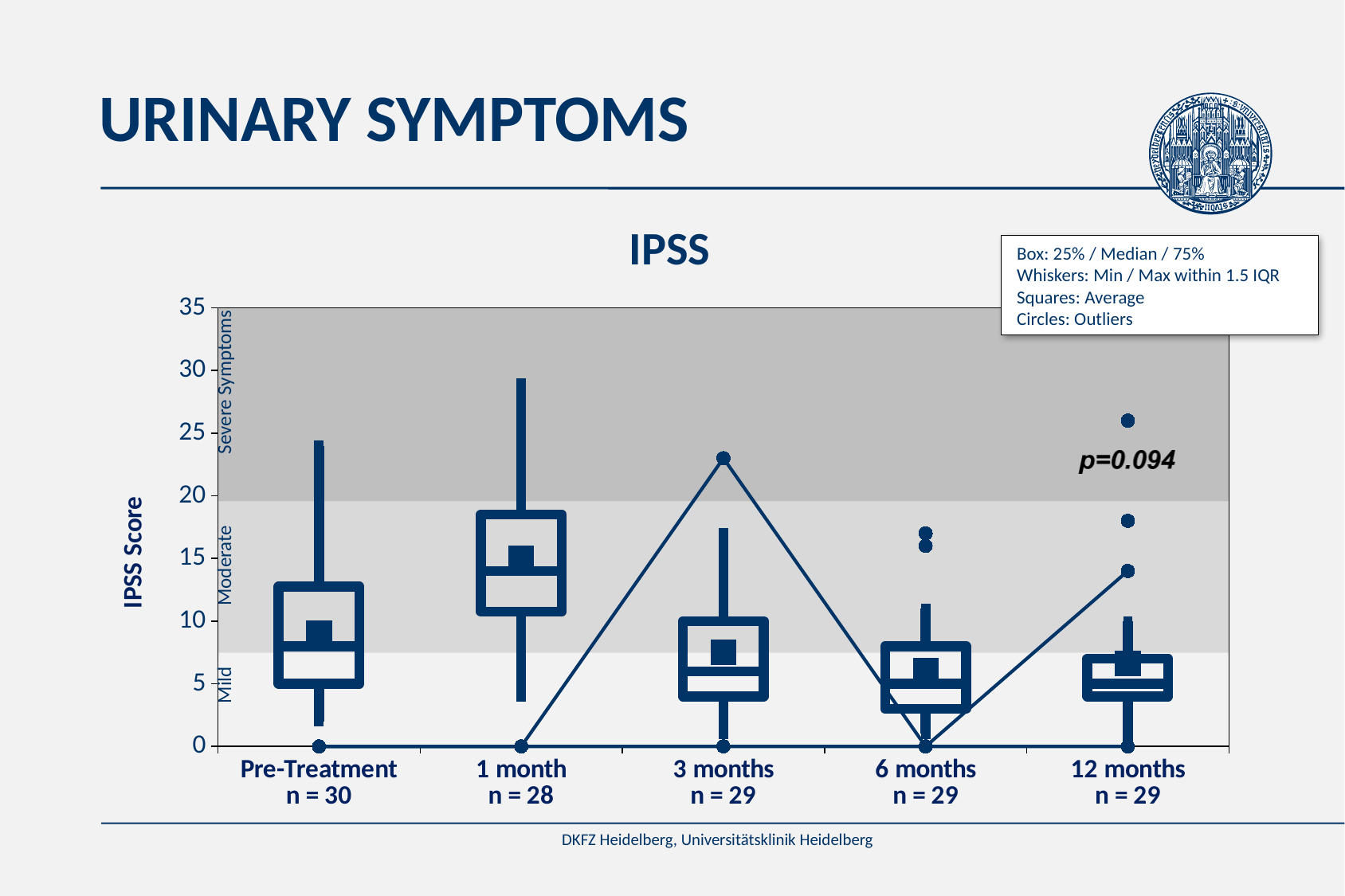
Is the upper whisker at Pre-Treatment greater or less than 20? greater What is the sample size (n) at Pre-Treatment in the IPSS chart? n = 30 What p-value is printed on the IPSS chart? p=0.094 Is the median IPSS score at Pre-Treatment greater or less than 10? less What kind of chart is shown on the slide? Box plot What is the sample size (n) at 1 month in the IPSS chart? n = 28 Which time point has the highest upper whisker in the IPSS chart? 1 month What is the title of the chart? IPSS Is the median IPSS score at 1 month greater or less than 10? greater Which time point has the highest median IPSS score? 1 month According to the legend box, what do the squares in the IPSS chart represent? Average How many time points are shown on the x axis of the IPSS chart? 5